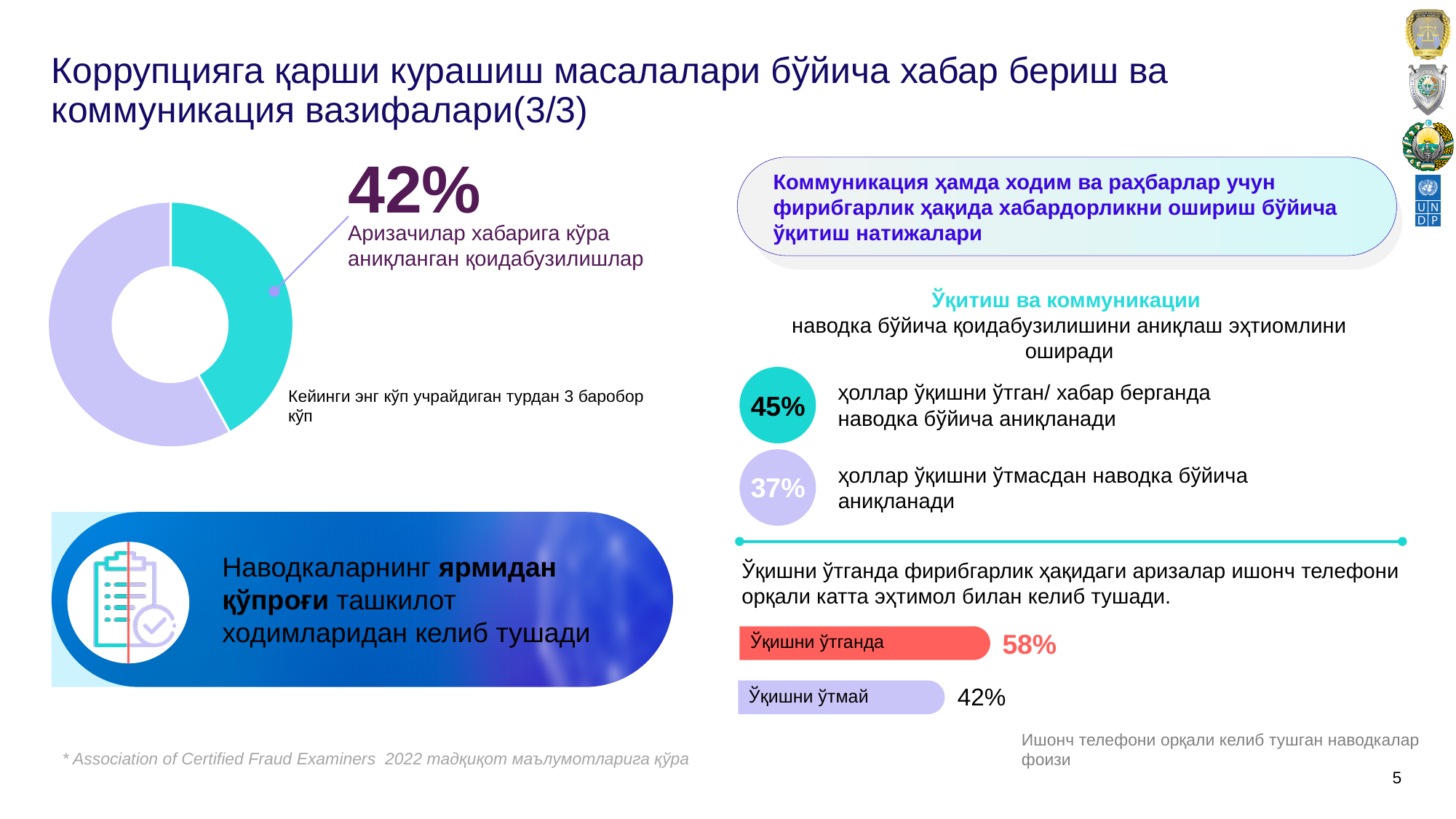
In the donut chart on the left, how many slices are there? 2 In the bar chart at the bottom right, what is the difference between Ўқишни ўтганда and Ўқишни ўтмай? 16% In the donut chart on the left, what share is labelled for the teal slice (Аризачилар хабарига кўра аниқланган қоидабузилишлар)? 42% In the bar chart at the bottom right, how many bars are shown? 2 In the bar chart at the bottom right, what is the value for Ўқишни ўтганда? 58% What kind of chart is shown on the left side of the slide? Donut (pie) chart In the bar chart at the bottom right, which category has the highest value? Ўқишни ўтганда In the bar chart at the bottom right, what is the value for Ўқишни ўтмай? 42% In the bar chart at the bottom right, what colour is the bar for Ўқишни ўтганда? Red In the bar chart at the bottom right, which category has the lowest value? Ўқишни ўтмай What kind of chart is shown at the bottom right of the slide (Ўқишни ўтганда / Ўқишни ўтмай)? Bar chart In the donut chart on the left, is the teal slice (42%) larger or smaller than the lavender slice? smaller